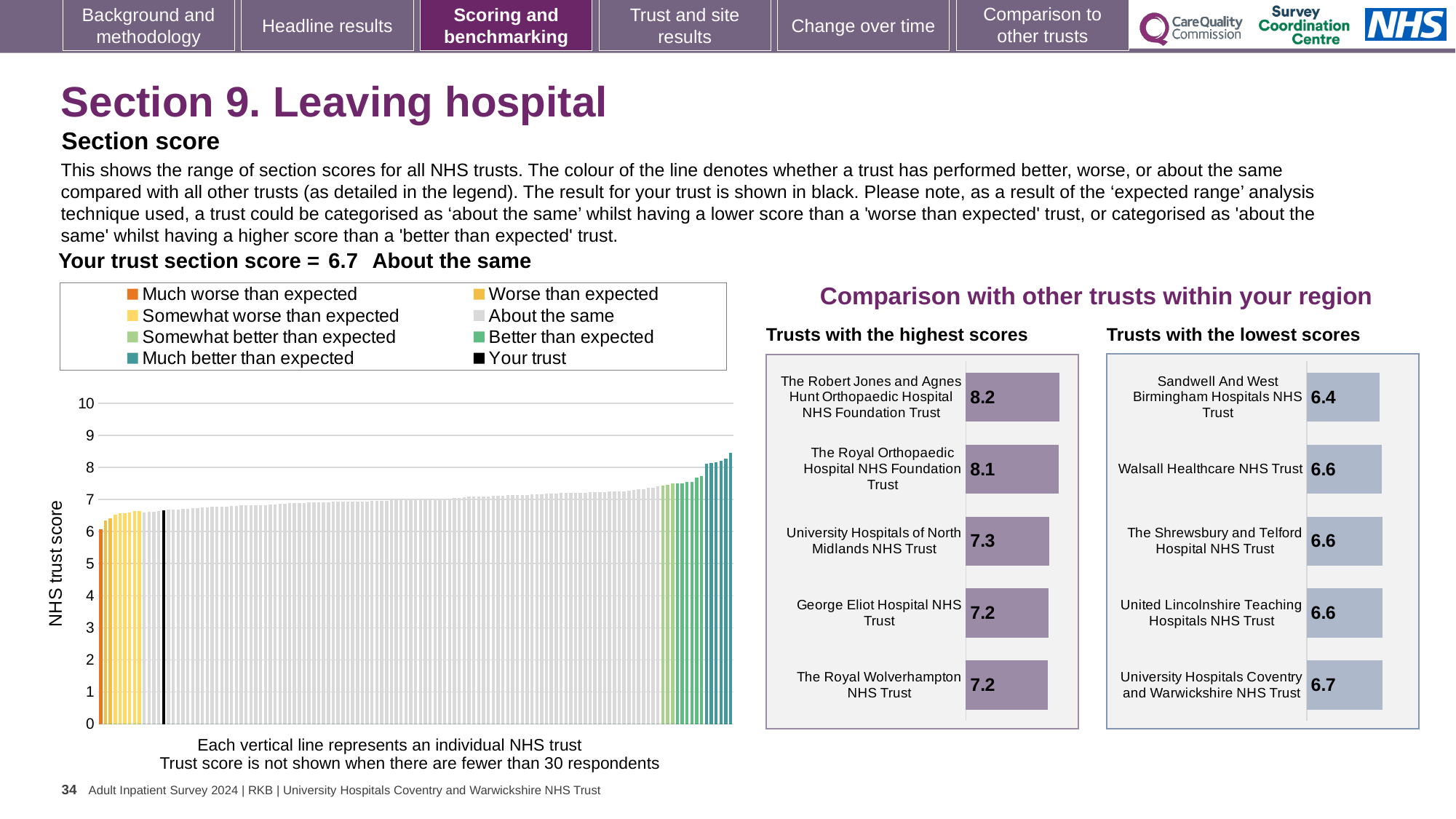
In the 'Trusts with the highest scores' chart, which trust has the highest score? The Robert Jones and Agnes Hunt Orthopaedic Hospital NHS Foundation Trust In the 'Trusts with the lowest scores' chart, what is the score for University Hospitals Coventry and Warwickshire NHS Trust? 6.7 In the 'Trusts with the lowest scores' chart, how many trusts are shown? 5 In the 'Trusts with the lowest scores' chart, what is the score for Sandwell And West Birmingham Hospitals NHS Trust? 6.4 In the 'Trusts with the highest scores' chart, what is the score for The Robert Jones and Agnes Hunt Orthopaedic Hospital NHS Foundation Trust? 8.2 In the 'Trusts with the lowest scores' chart, which trust has the lowest score? Sandwell And West Birmingham Hospitals NHS Trust In the main chart on the left showing all NHS trusts, how many entries does the legend list? 8 In the main chart on the left showing all NHS trusts, what kind of chart is it? Bar chart In the main chart on the left showing all NHS trusts, do the values rise or fall from left to right? Rise Which is larger: the score for Walsall Healthcare NHS Trust in the 'Trusts with the lowest scores' chart or the score for The Royal Wolverhampton NHS Trust in the 'Trusts with the highest scores' chart? The Royal Wolverhampton NHS Trust In the 'Trusts with the highest scores' chart, what is the score for University Hospitals of North Midlands NHS Trust? 7.3 In the 'Trusts with the highest scores' chart, what is the difference between the scores of The Royal Orthopaedic Hospital NHS Foundation Trust and George Eliot Hospital NHS Trust? 0.9